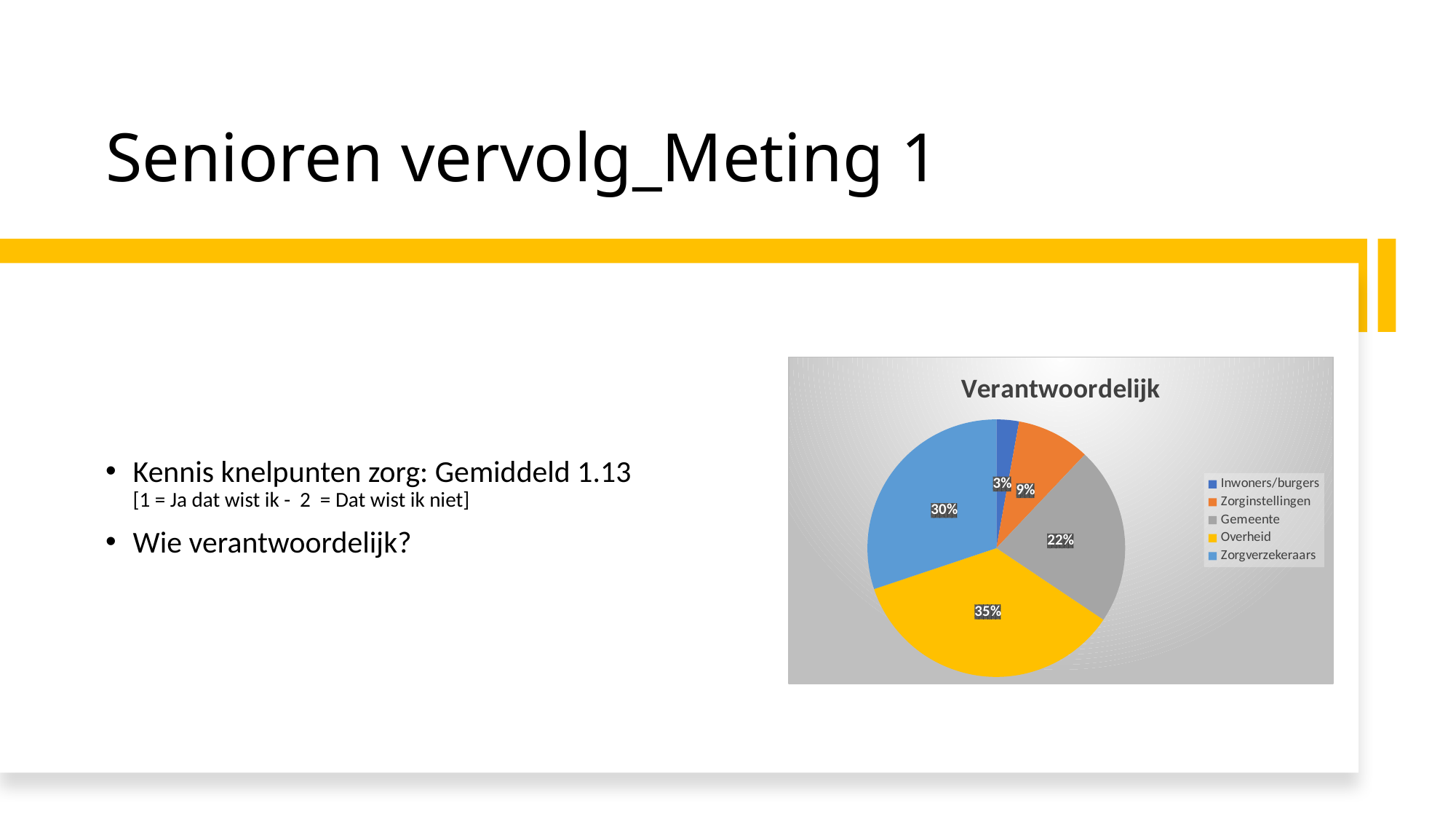
What share of the pie does Overheid have? 35% How many categories does the pie chart show? 5 Which is larger, the share for Zorgverzekeraars or the share for Gemeente? Zorgverzekeraars What kind of chart is shown on the slide? pie chart What is the difference between the shares of Overheid and Gemeente? 13% What share of the pie does Gemeente have? 22% Which category has the largest slice of the pie? Overheid What share of the pie does Zorginstellingen have? 9% Which category has the smallest slice of the pie? Inwoners/burgers What is the title of the chart? Verantwoordelijk